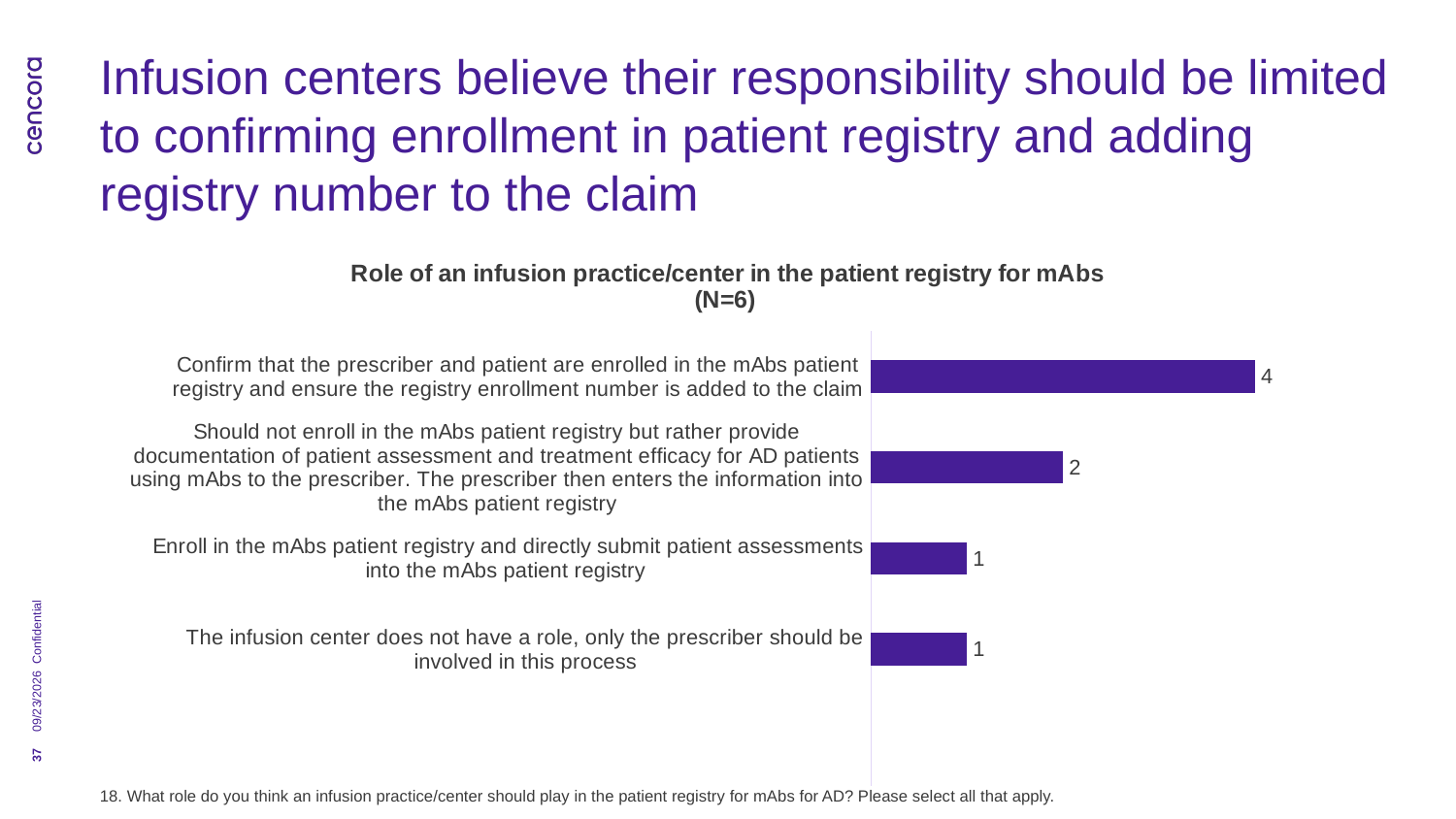
What kind of chart is shown on the slide? Bar chart What is the difference between the value for confirming enrollment and adding the registry number to the claim and the value for 'The infusion center does not have a role, only the prescriber should be involved in this process'? 3 What is the difference between the value for not enrolling but providing documentation to the prescriber and the value for enrolling and directly submitting patient assessments? 1 Which is larger: the value for confirming enrollment and adding the registry number to the claim, or the value for not enrolling but providing documentation to the prescriber? Confirm that the prescriber and patient are enrolled in the mAbs patient registry and ensure the registry enrollment number is added to the claim What value is shown for the option that infusion centers should not enroll in the registry but provide documentation to the prescriber? 2 What value is shown for 'Confirm that the prescriber and patient are enrolled in the mAbs patient registry and ensure the registry enrollment number is added to the claim'? 4 How many categories are shown in the chart? 4 What is the title of the chart? Role of an infusion practice/center in the patient registry for mAbs (N=6) What is the sample size (N) stated in the chart title? 6 What value is shown for 'Enroll in the mAbs patient registry and directly submit patient assessments into the mAbs patient registry'? 1 Which category has the highest value? Confirm that the prescriber and patient are enrolled in the mAbs patient registry and ensure the registry enrollment number is added to the claim